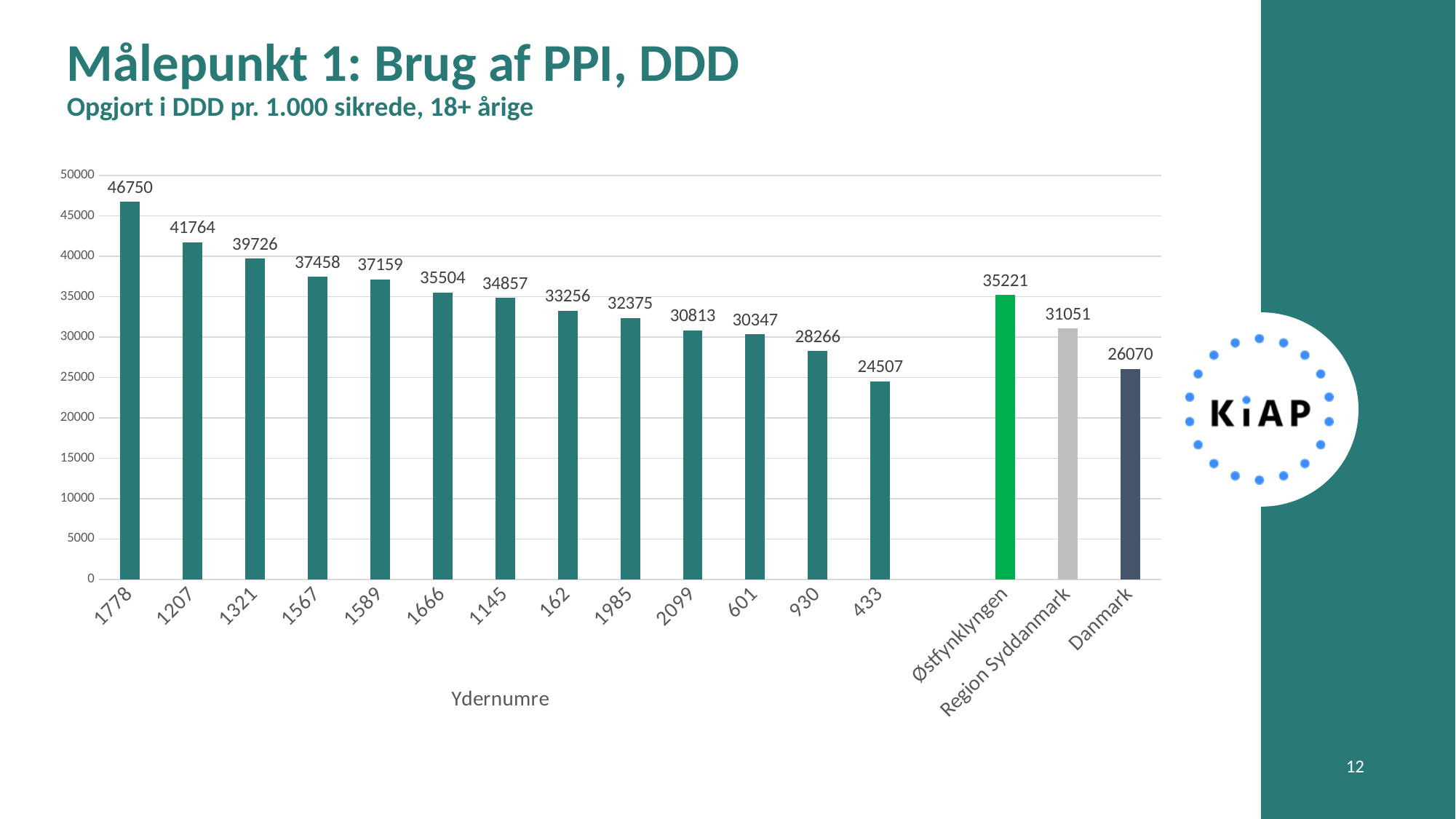
What is the value for Danmark? 26070 What is the value for Region Syddanmark? 31051 What is the value for Østfynklyngen? 35221 What is the label of the x axis? Ydernumre Is the value for ydernummer 930 greater or less than 30000? less Which is larger, the value for ydernummer 1666 or for Østfynklyngen? 1666 How many bars are shown in the chart? 16 What is the value for ydernummer 1778? 46750 Which category has the lowest value? 433 What is the difference between the values for Østfynklyngen and Danmark? 9151 What kind of chart is shown on the slide? bar chart Which category has the highest value? 1778